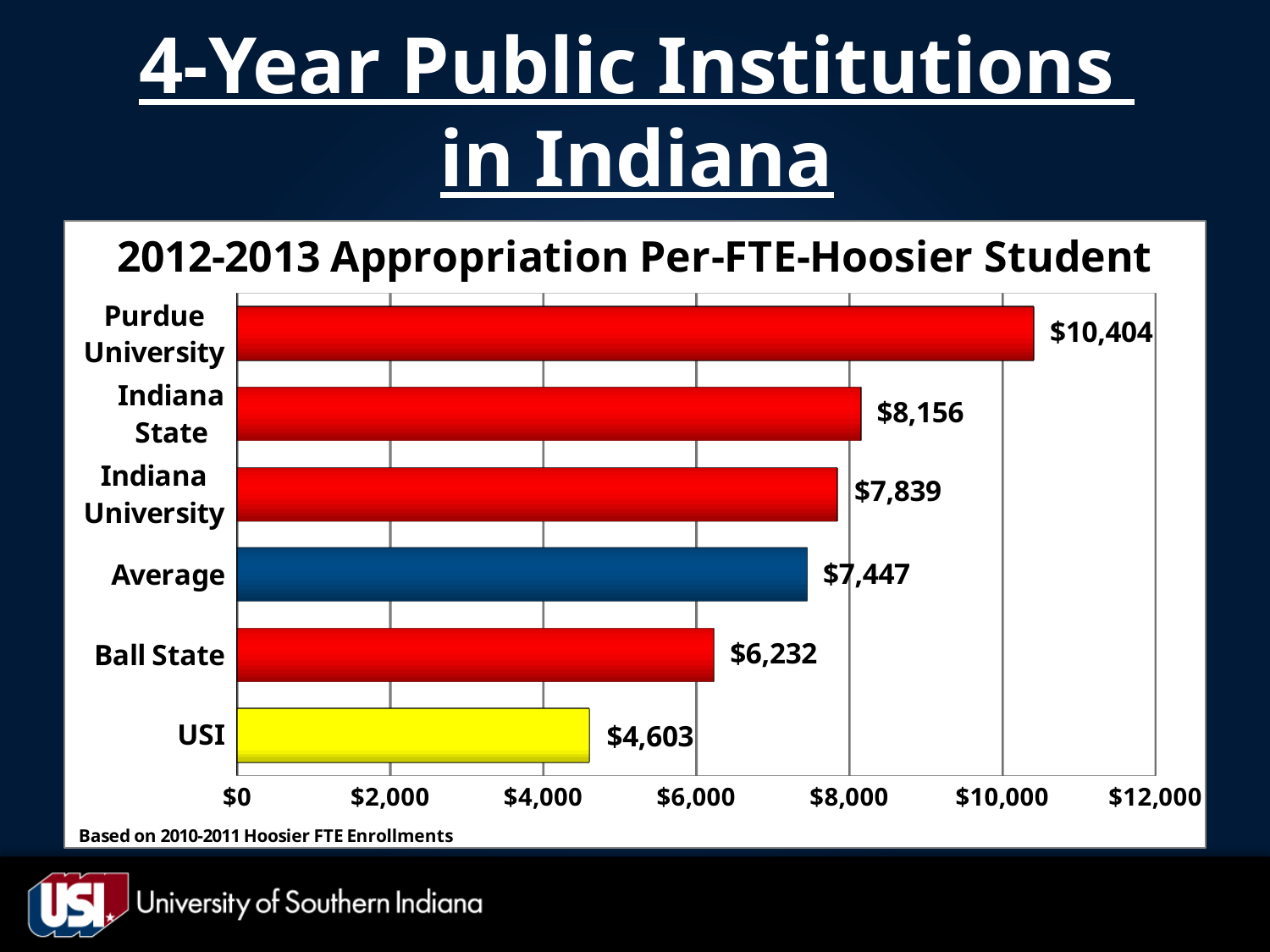
Which is larger, the value for Ball State or the value for Indiana University? Indiana University What is the appropriation per FTE Hoosier student for Purdue University? $10,404 What is the value shown for the Average bar? $7,447 How many bars are shown on the chart? 6 What is the difference between Indiana State's value and Indiana University's value? $317 What is the difference between Purdue University's value and USI's value? $5,801 Which institution has the highest appropriation per FTE Hoosier student? Purdue University What kind of chart is shown on the slide? Bar chart Is the value for Ball State greater or less than $6,000? greater What is the value shown for USI? $4,603 Which category has the lowest value on the chart? USI What is the title of the chart? 2012-2013 Appropriation Per-FTE-Hoosier Student